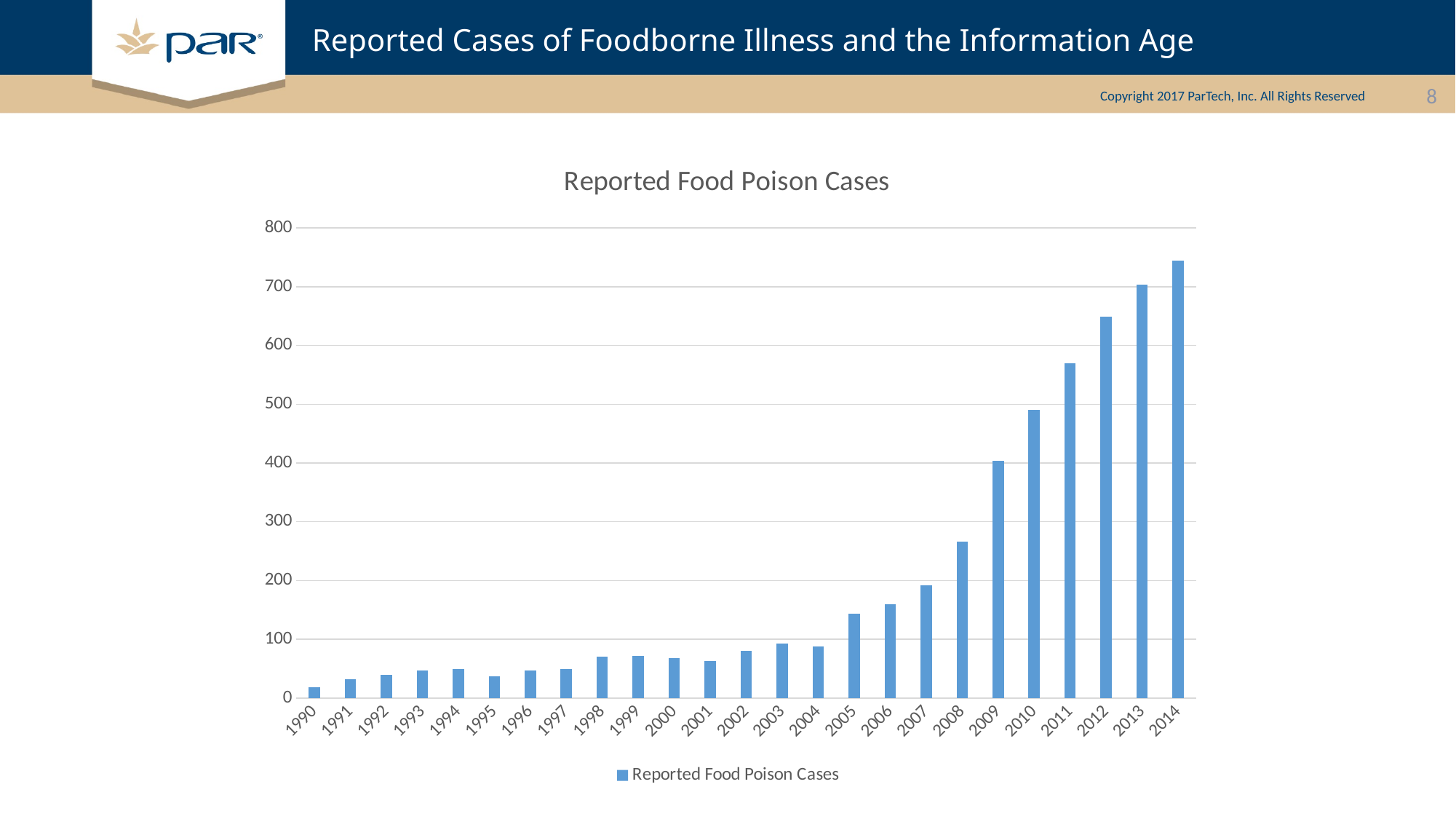
Is the value for 2008 greater or less than 200? greater Is the value for 2014 greater or less than 700? greater What kind of chart is shown on the slide? bar chart Which year has more reported cases, 2010 or 2012? 2012 Which year has the lowest number of reported food poison cases? 1990 Is the value for 2011 greater or less than 500? greater How many series does the legend list? 1 Do the reported food poison cases generally rise or fall from 1990 to 2014? rise How many years are shown on the x axis? 25 What is the title of the chart? Reported Food Poison Cases Which year has the highest number of reported food poison cases? 2014